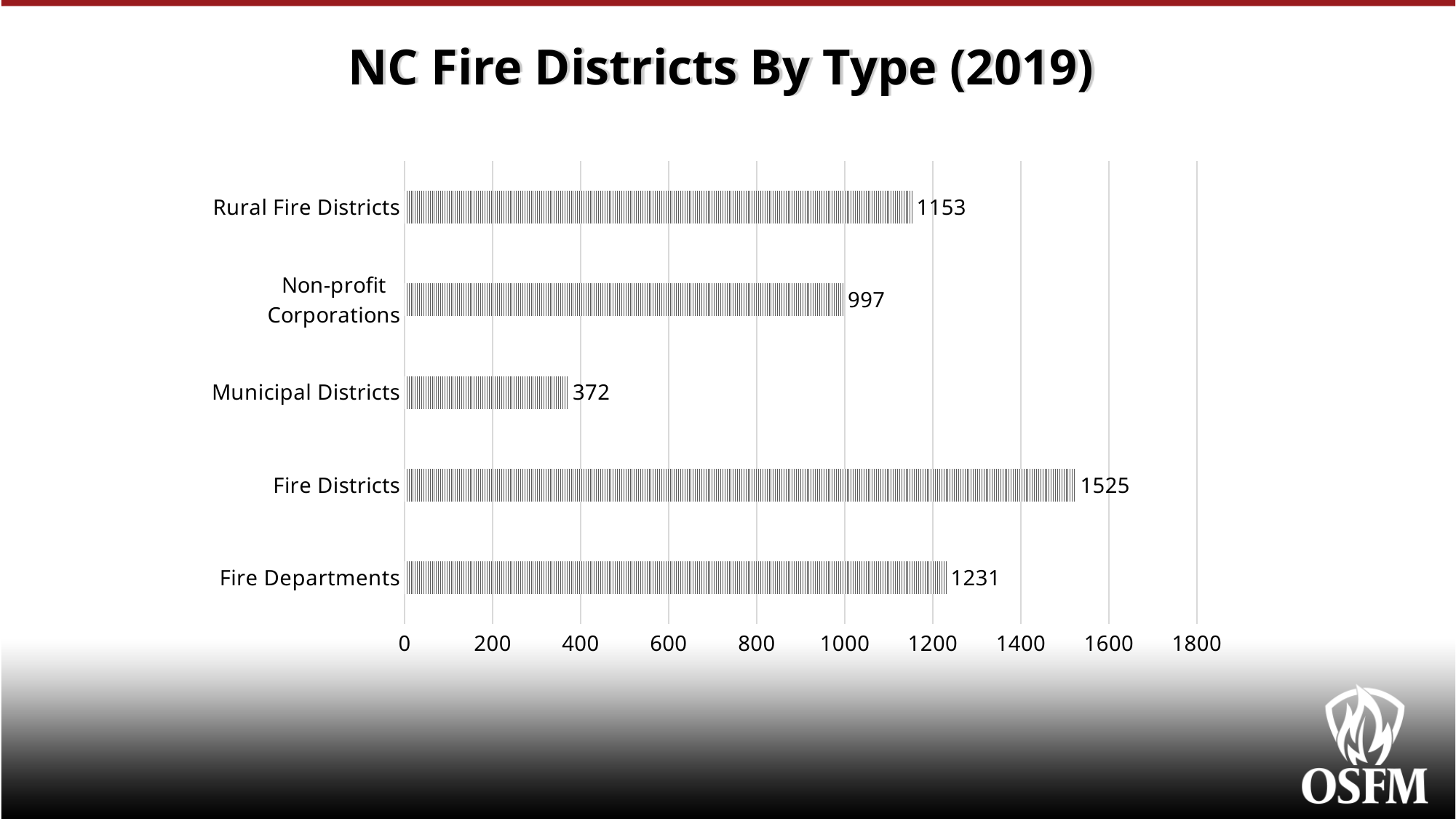
How many categories are shown in the chart? 5 Which category has the highest value? Fire Districts Is the value for Non-profit Corporations greater or less than 1000? less What is the value for Rural Fire Districts? 1153 What kind of chart is shown on the slide? bar chart What is the difference between the values for Rural Fire Districts and Non-profit Corporations? 156 What is the value for Fire Departments? 1231 Which category has the lowest value? Municipal Districts Which is larger, the value for Fire Departments or the value for Rural Fire Districts? Fire Departments What is the difference between the values for Fire Districts and Fire Departments? 294 What is the value for Non-profit Corporations? 997 What is the value for Municipal Districts? 372